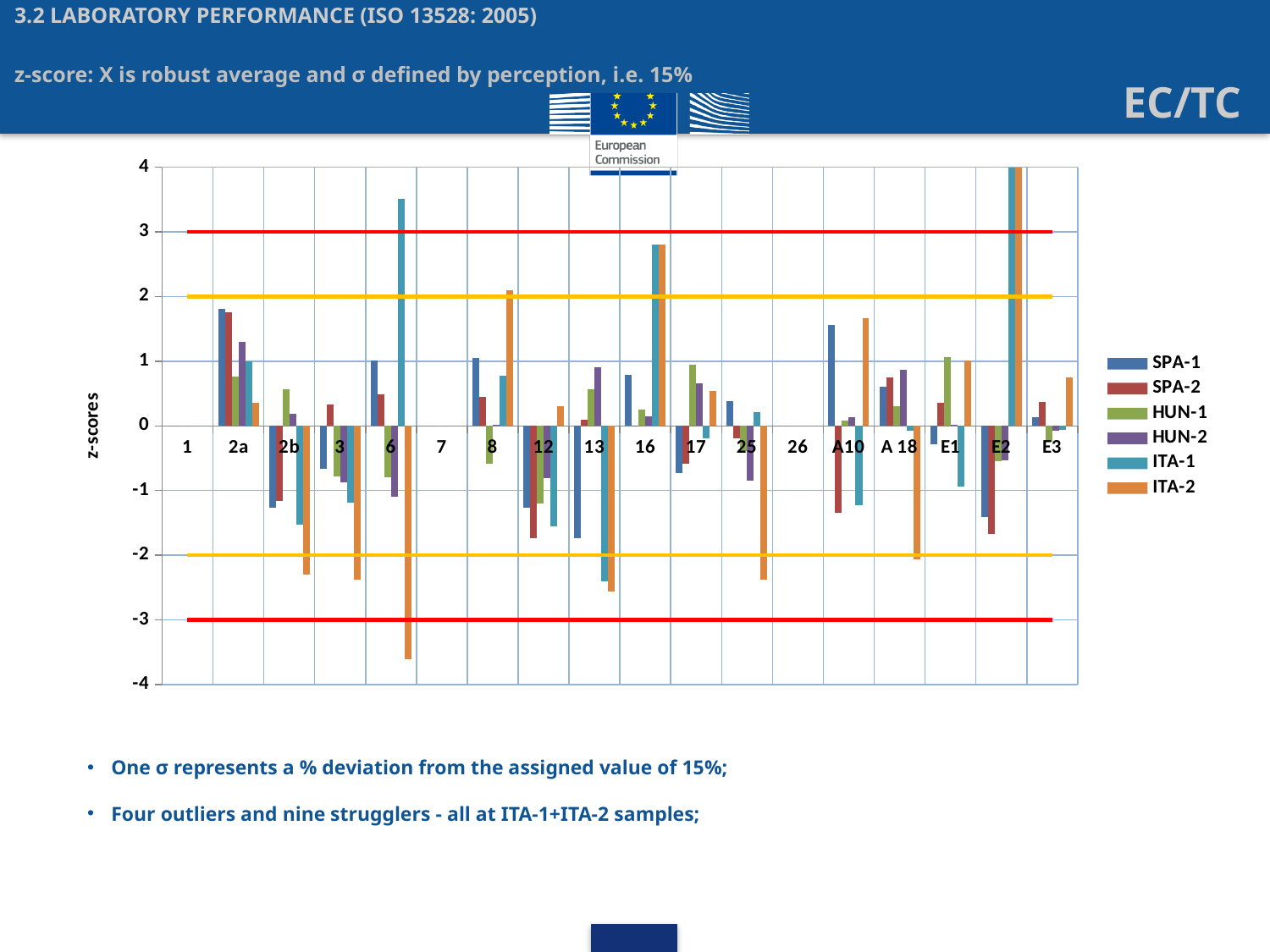
Is the ITA-1 value for category 16 greater or less than 2? greater For category 6, which series has the larger value, ITA-1 or SPA-1? ITA-1 Which colour represents the ITA-2 series in the legend? orange Is the ITA-1 value for category 6 greater or less than 3? greater What kind of chart is shown on the slide? bar chart Is the ITA-2 value for category 2b greater or less than -2? less How many categories are shown along the x axis? 18 What is the label of the vertical axis? z-scores How many series does the legend list? 6 Which series has the highest value for category 6? ITA-1